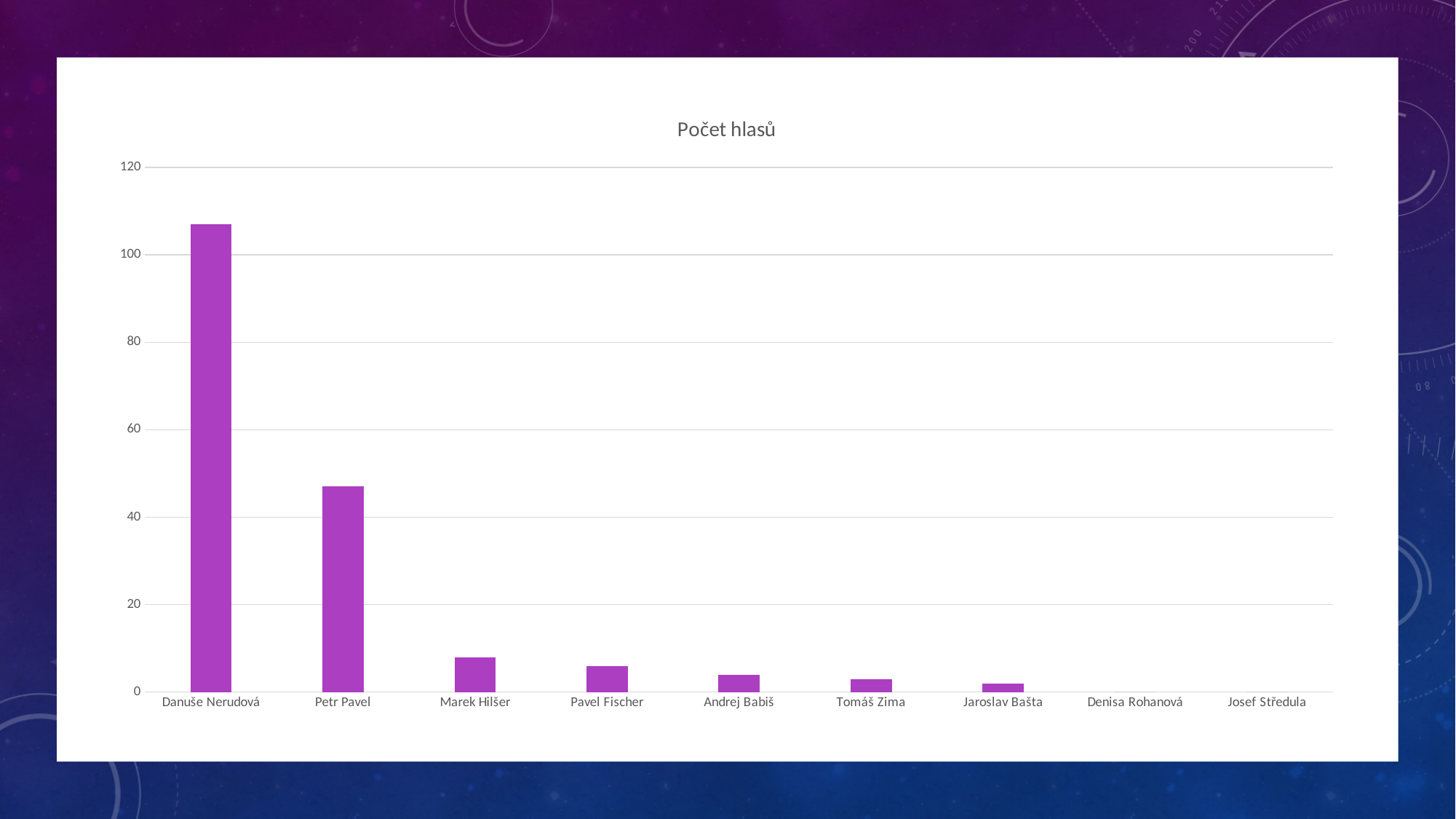
What colour are the bars in the chart? purple Is the value for Petr Pavel greater or less than 60? less Is the value for Marek Hilšer greater or less than 20? less What is the title of the chart? Počet hlasů Which is larger, the value for Petr Pavel or the value for Marek Hilšer? Petr Pavel What kind of chart is shown on the slide? bar chart How many categories are shown on the x axis of the chart? 9 Which is larger, the value for Danuše Nerudová or the value for Petr Pavel? Danuše Nerudová Is the value for Danuše Nerudová greater or less than 100? greater Which category has the highest value in the chart? Danuše Nerudová Do the values rise or fall from left to right along the x axis? fall